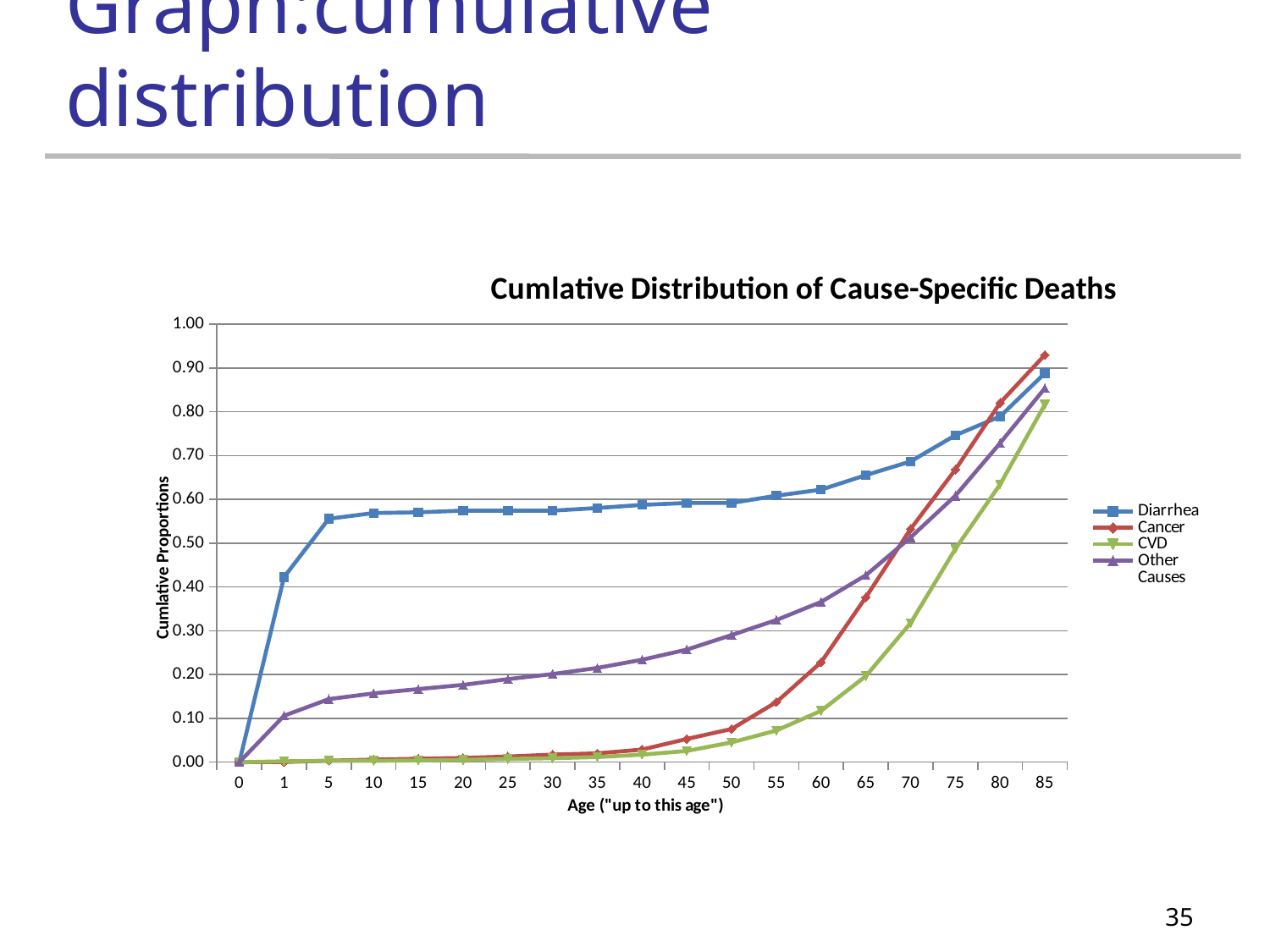
At age 85, which is higher: Cancer or CVD? Cancer What kind of chart is shown on the slide? line chart Is the value for Other Causes at age 50 greater or less than 0.20? greater At age 40, which is higher: Diarrhea or Other Causes? Diarrhea What is the title of the chart? Cumlative Distribution of Cause-Specific Deaths What is the label of the x axis? Age ("up to this age") How many series does the legend list? 4 Is the value for Diarrhea at age 5 greater or less than 0.50? greater Is the value for CVD at age 70 greater or less than 0.40? less How many age categories are shown along the x axis? 19 Which series has the highest value at age 85? Cancer